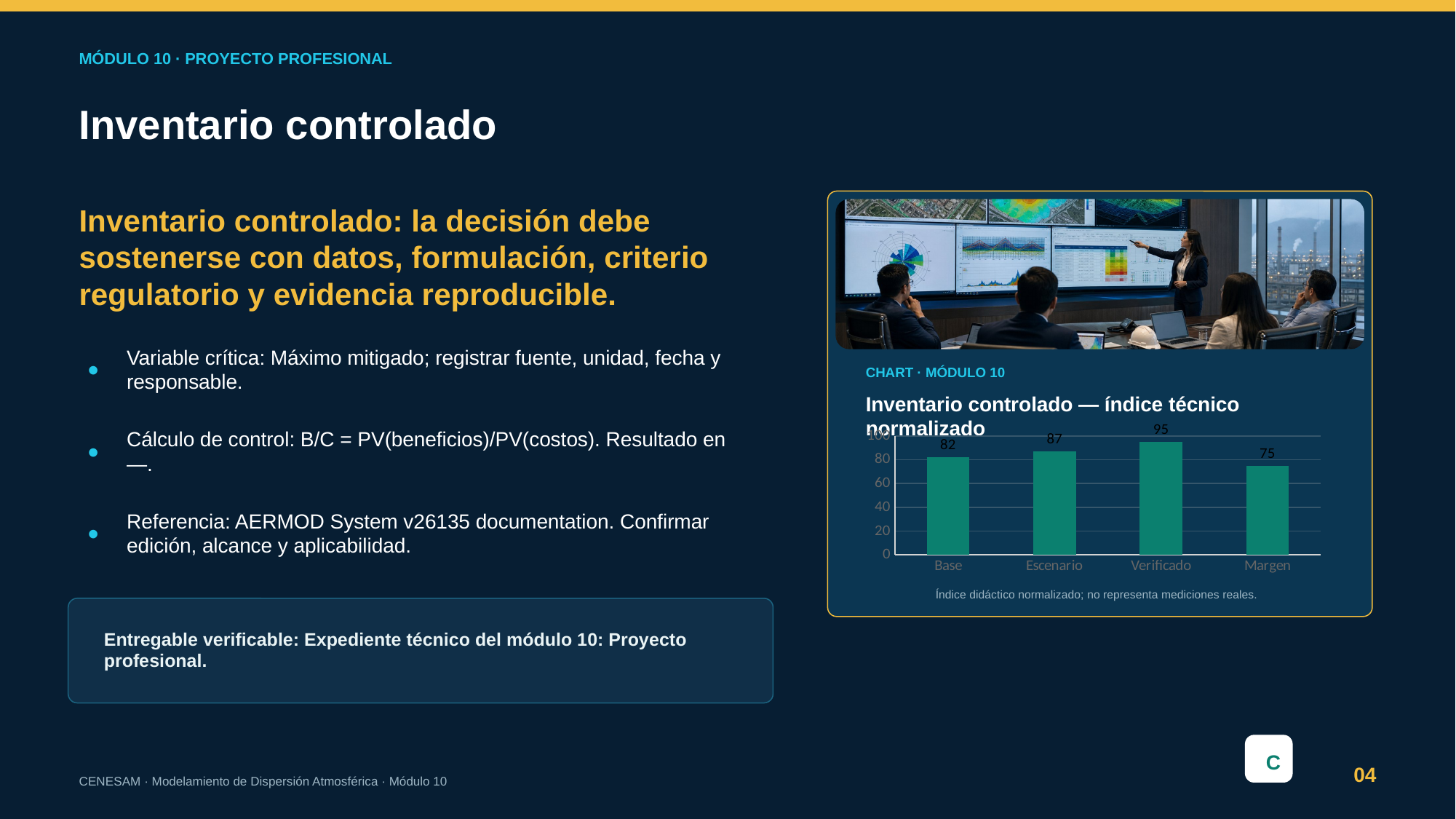
What is the value for Escenario? 87 What is the difference between the values for Verificado and Margen? 20 What is the value for Base? 82 What kind of chart is shown? bar chart How many categories are shown on the x axis? 4 Which category has the highest value? Verificado Which is larger, the value for Base or the value for Escenario? Escenario Is the value for Margen greater or less than 80? less What is the value for Margen? 75 What is the title of the chart? Inventario controlado — índice técnico normalizado What is the value for Verificado? 95 Which category has the lowest value? Margen